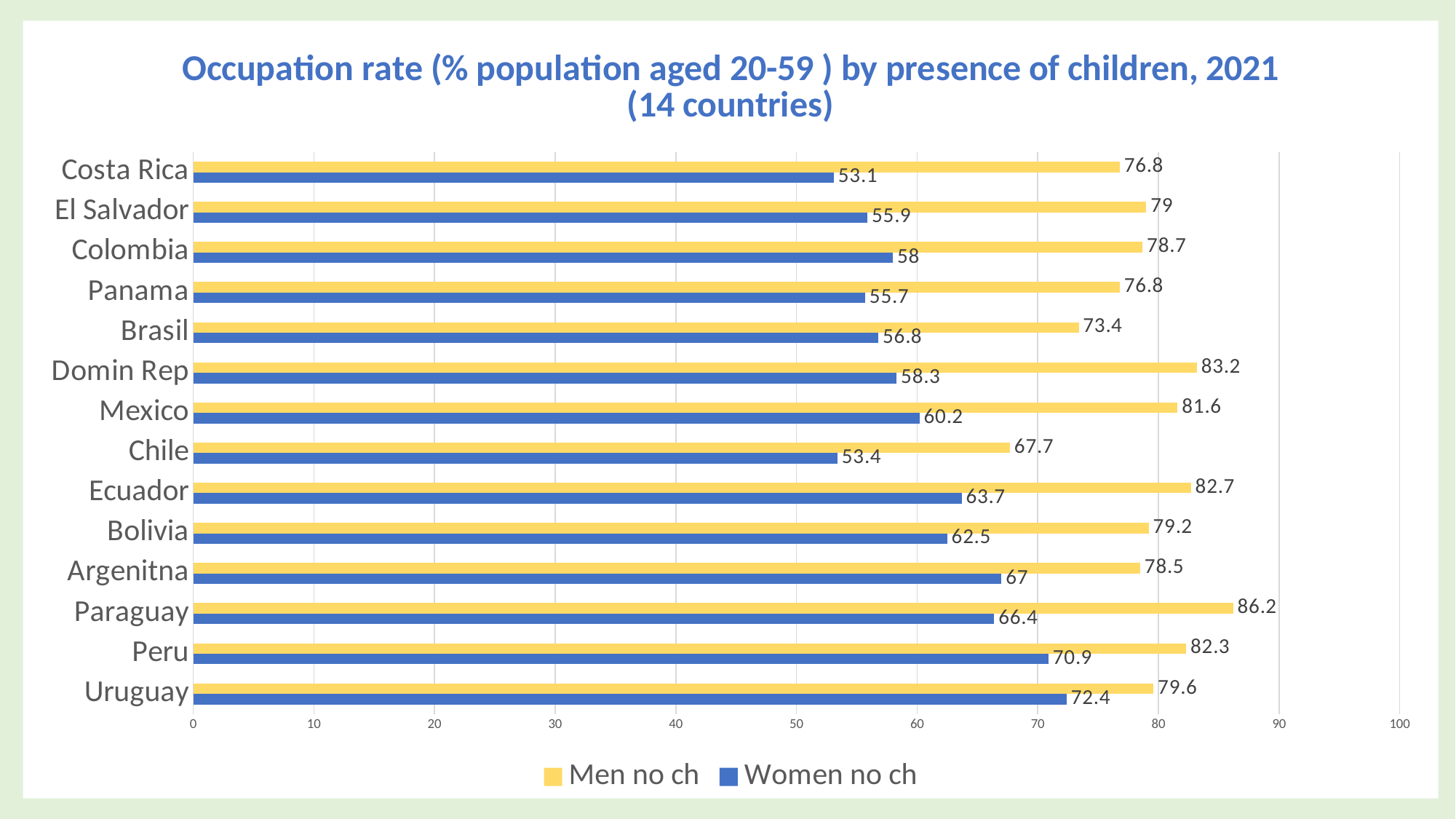
What is the difference between Men no ch and Women no ch in Paraguay? 19.8 What kind of chart is shown on the slide? Bar chart How many series does the legend list? 2 What is the value for Women no ch in Mexico? 60.2 How many countries are shown in the chart? 14 What is the difference between Men no ch and Women no ch in Uruguay? 7.2 Which is larger, the Men no ch value for Domin Rep or for Mexico? Domin Rep Which country has the lowest value for Men no ch? Chile What is the value for Men no ch in Paraguay? 86.2 Which country has the highest value for Men no ch? Paraguay Which country has the highest value for Women no ch? Uruguay What is the value for Women no ch in Uruguay? 72.4